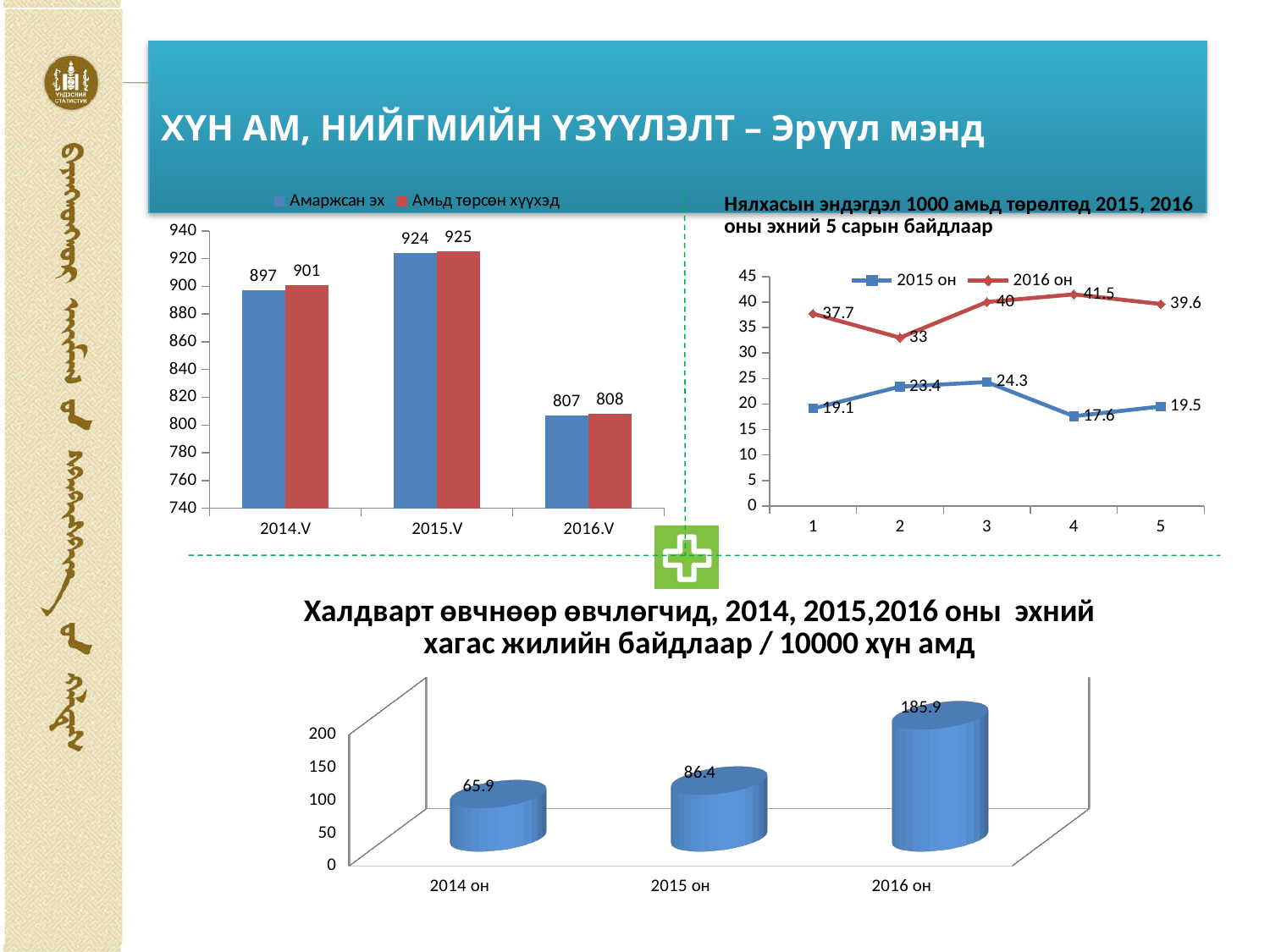
In the bottom chart titled 'Халдварт өвчнөөр өвчлөгчид, 2014, 2015,2016 оны эхний хагас жилийн байдлаар / 10000 хүн амд', do the values rise or fall from 2014 он to 2016 он? rise In the top-left bar chart, how many series does the legend list? 2 In the top-left bar chart, what is the value of Амаржсан эх for 2015.V? 924 In the top-left bar chart, what is the difference between Амьд төрсөн хүүхэд in 2015.V and 2016.V? 117 In the top-left bar chart, what is the value of Амьд төрсөн хүүхэд for 2016.V? 808 In the bottom chart titled 'Халдварт өвчнөөр өвчлөгчид, 2014, 2015,2016 оны эхний хагас жилийн байдлаар / 10000 хүн амд', what is the value for 2016 он? 185.9 In the line chart titled 'Нялхасын эндэгдэл 1000 амьд төрөлтөд 2015, 2016 оны эхний 5 сарын байдлаар', what is the value for 2015 он at month 1? 19.1 In the line chart titled 'Нялхасын эндэгдэл 1000 амьд төрөлтөд 2015, 2016 оны эхний 5 сарын байдлаар', what is the value for 2016 он at month 4? 41.5 In the top-left bar chart, which period has the lowest value for Амаржсан эх? 2016.V In the line chart titled 'Нялхасын эндэгдэл 1000 амьд төрөлтөд 2015, 2016 оны эхний 5 сарын байдлаар', which is larger at month 3: 2015 он or 2016 он? 2016 он In the line chart titled 'Нялхасын эндэгдэл 1000 амьд төрөлтөд 2015, 2016 оны эхний 5 сарын байдлаар', which month has the lowest value for 2016 он? 2 In the line chart titled 'Нялхасын эндэгдэл 1000 амьд төрөлтөд 2015, 2016 оны эхний 5 сарын байдлаар', how many points are plotted along the x axis for each series? 5